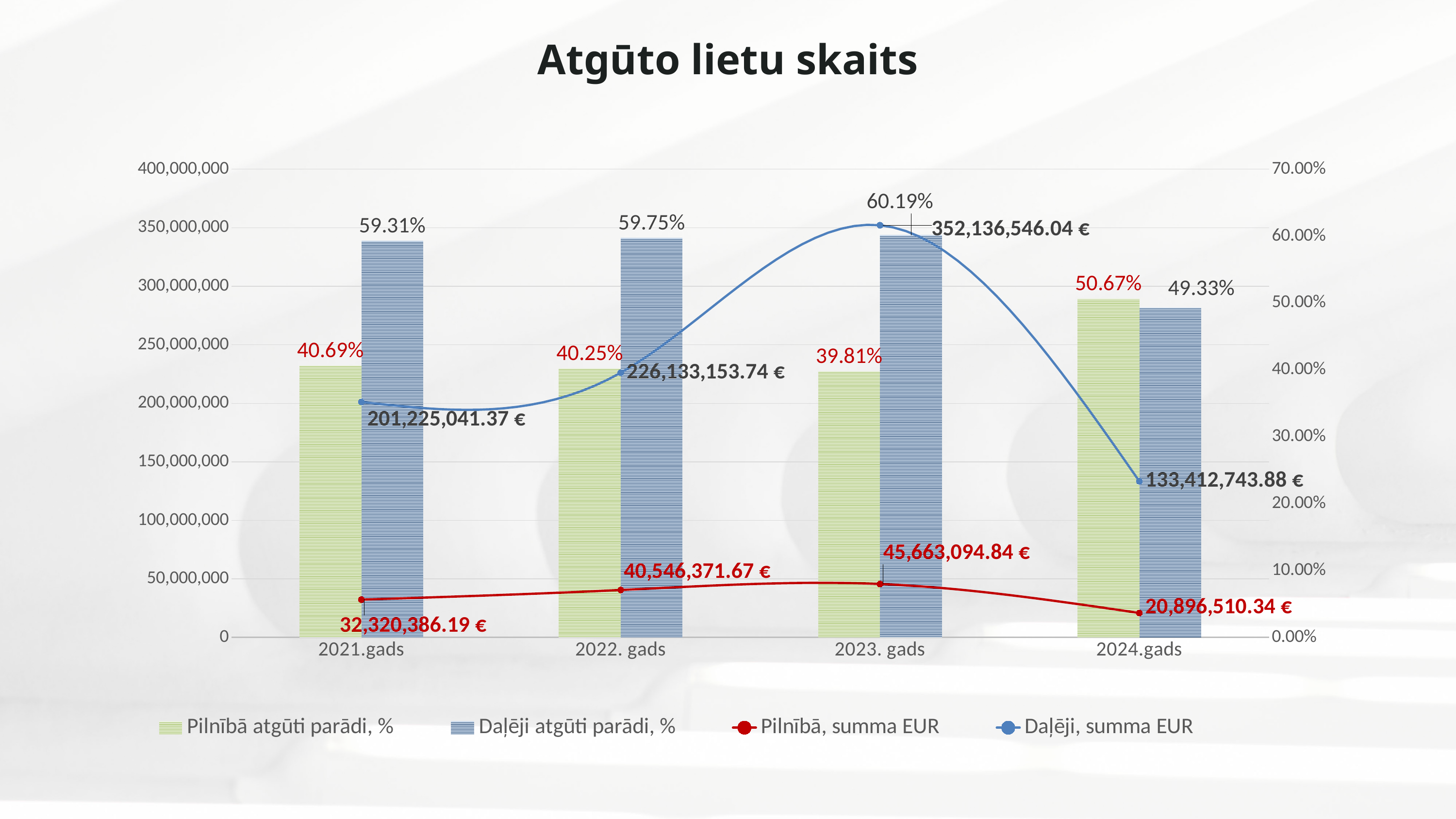
In which year is Pilnībā, summa EUR the lowest? 2024.gads What is the value of Pilnībā, summa EUR for 2021.gads? 32,320,386.19 € What is the difference between Daļēji atgūti parādi, % and Pilnībā atgūti parādi, % in 2021.gads? 18.62% By how much did Daļēji, summa EUR increase from 2022. gads to 2023. gads? 126,003,392.30 € How many series does the legend list? 4 What percentage is shown for Daļēji atgūti parādi, % in 2022. gads? 59.75% Which is larger in 2024.gads: Pilnībā atgūti parādi, % or Daļēji atgūti parādi, %? Pilnībā atgūti parādi, % How many years are shown on the x axis? 4 What is the value of Daļēji, summa EUR for 2023. gads? 352,136,546.04 € In which year is Daļēji, summa EUR the highest? 2023. gads How does Pilnībā, summa EUR change from 2021.gads to 2023. gads? It rises What percentage is shown for Pilnībā atgūti parādi, % in 2024.gads? 50.67%